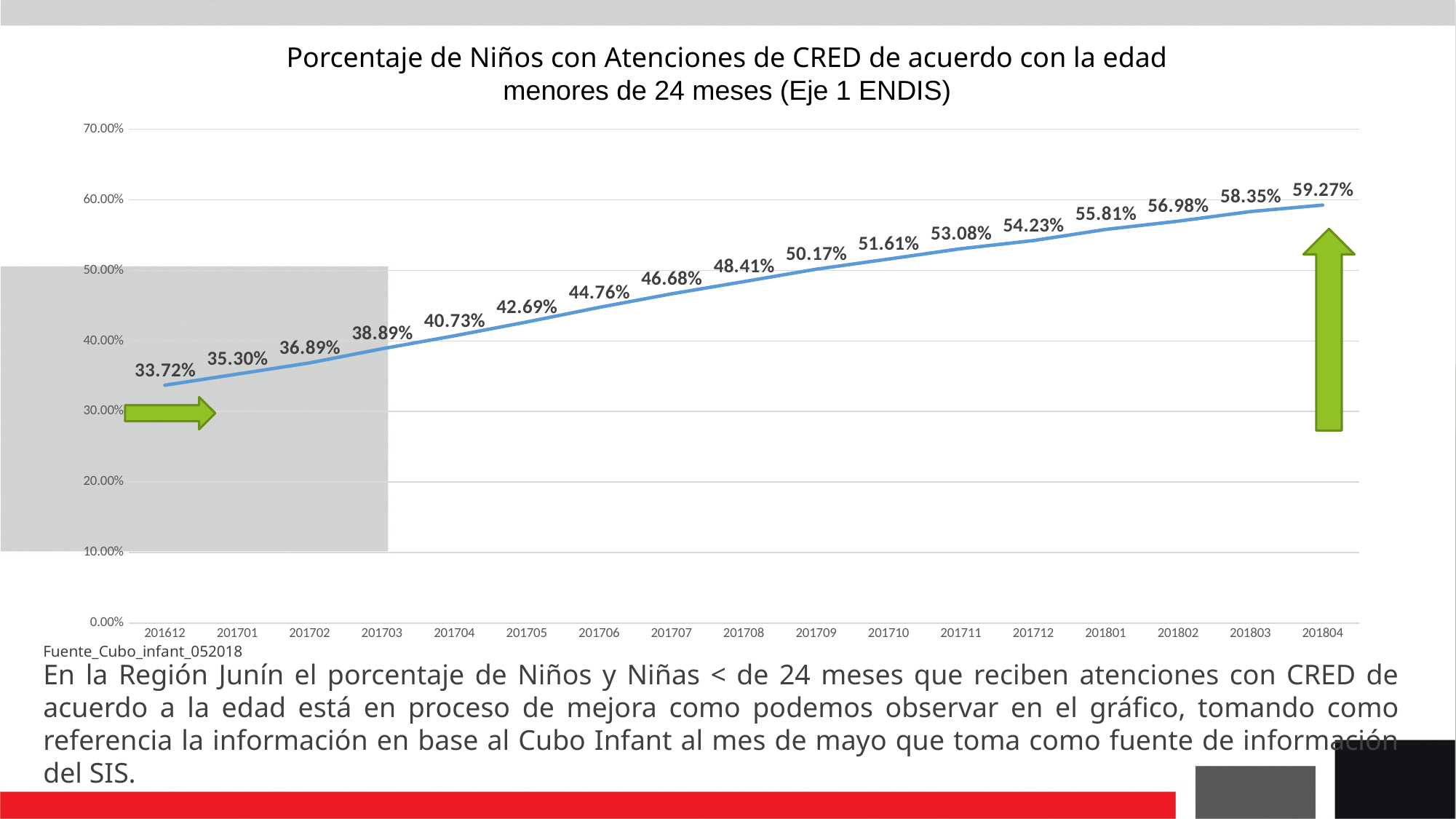
What is the difference between the values for 201804 and 201612? 25.55% What kind of chart is this? line chart What is the value for 201612? 33.72% Which period has the lowest value? 201612 How many periods are plotted on the x axis? 17 What is the value for 201801? 55.81% Is the value for 201707 greater or less than 50.00%? less What is the value for 201804? 59.27% Do the values rise or fall from 201612 to 201804? rise Which period has the highest value? 201804 What is the value for 201709? 50.17% Which is larger, the value for 201705 or the value for 201711? 201711